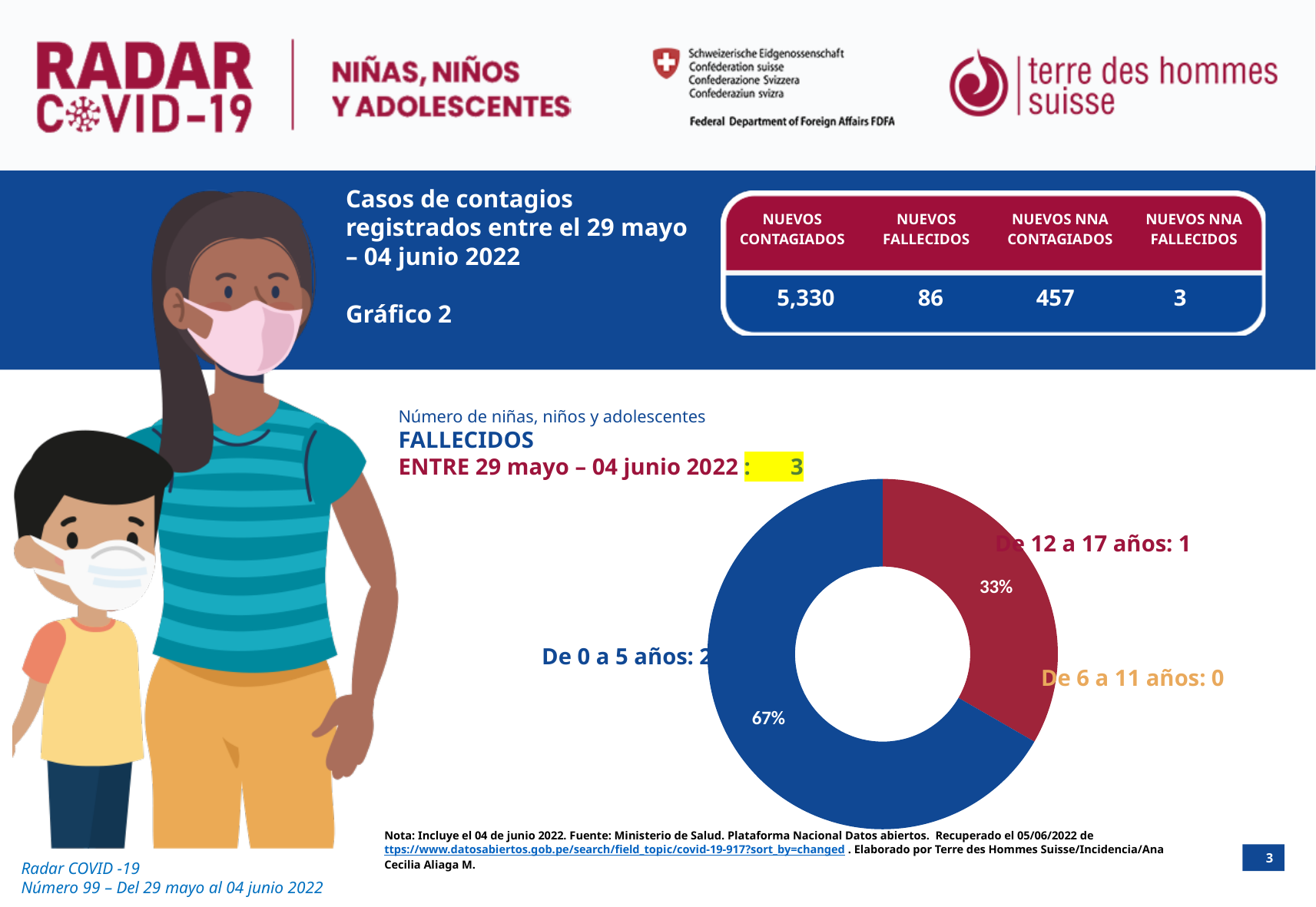
Which age group has the lowest number of deaths? De 6 a 11 años What is the value for 'De 0 a 5 años'? 2 What share of the pie does 'De 12 a 17 años' represent? 33% What is the difference between the values for 'De 0 a 5 años' and 'De 12 a 17 años'? 1 What is the value for 'De 6 a 11 años'? 0 Which is larger, the value for 'De 0 a 5 años' or 'De 12 a 17 años'? De 0 a 5 años What is the total number of deaths shown in the chart title? 3 How many age categories does the chart show? 3 What share of the pie does 'De 0 a 5 años' represent? 67% Which age group has the highest number of deaths? De 0 a 5 años What is the value for 'De 12 a 17 años'? 1 What kind of chart is shown on the slide? Pie chart (donut)